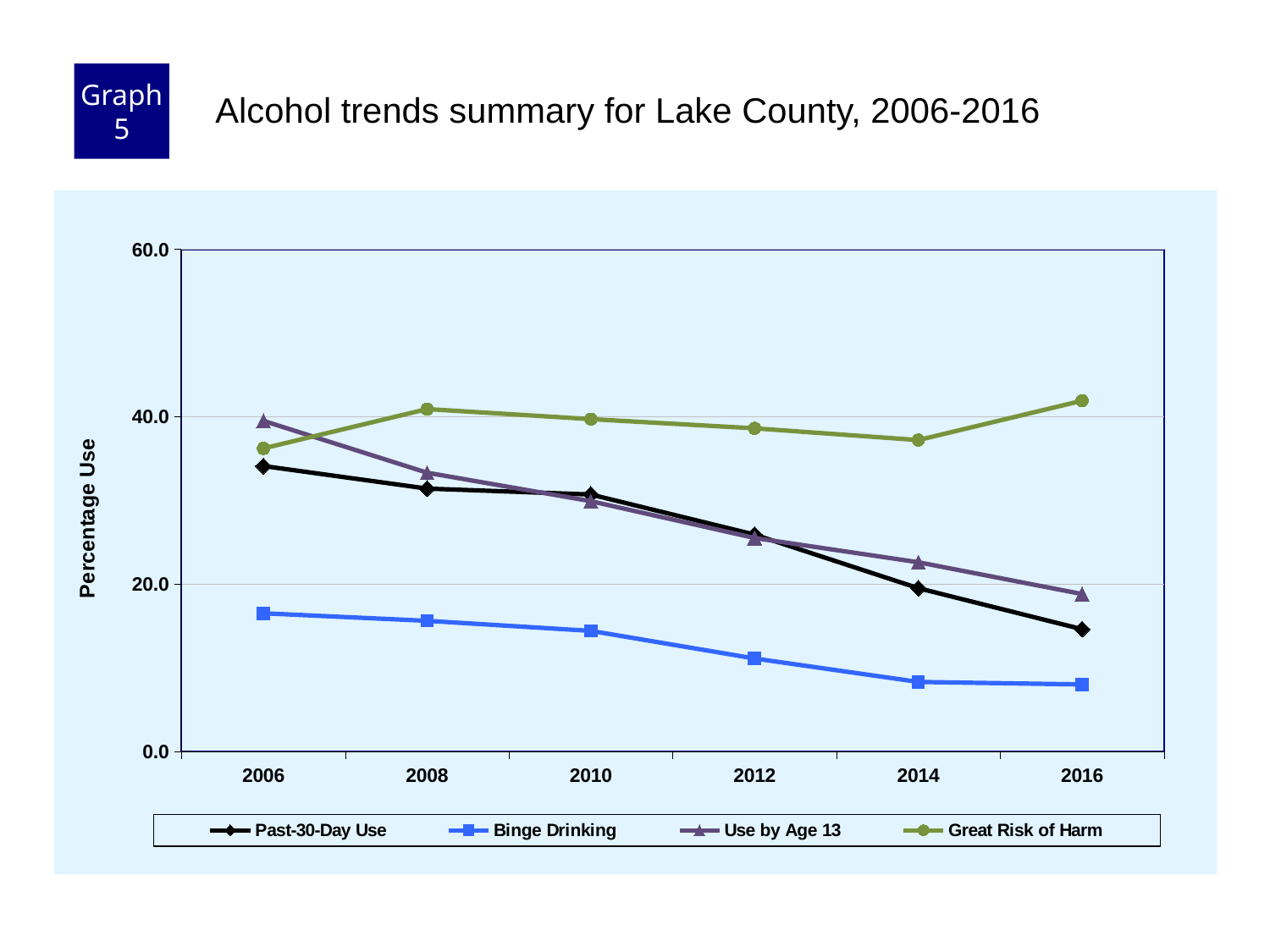
Is the value for Binge Drinking in 2006 greater or less than 20.0? less How many years are plotted along the x axis? 6 Is the value for Great Risk of Harm in 2016 greater or less than 40.0? greater In 2016, which is higher: Past-30-Day Use or Use by Age 13? Use by Age 13 What kind of chart is shown on the slide? Line chart Which series has the highest value in 2016? Great Risk of Harm Does the Binge Drinking line rise or fall from 2006 to 2016? Falls Does the Past-30-Day Use line rise or fall from 2006 to 2016? Falls What is the label on the y axis? Percentage Use Which series has the lowest value in 2006? Binge Drinking In 2006, which is higher: Use by Age 13 or Past-30-Day Use? Use by Age 13 How many series does the legend list? 4